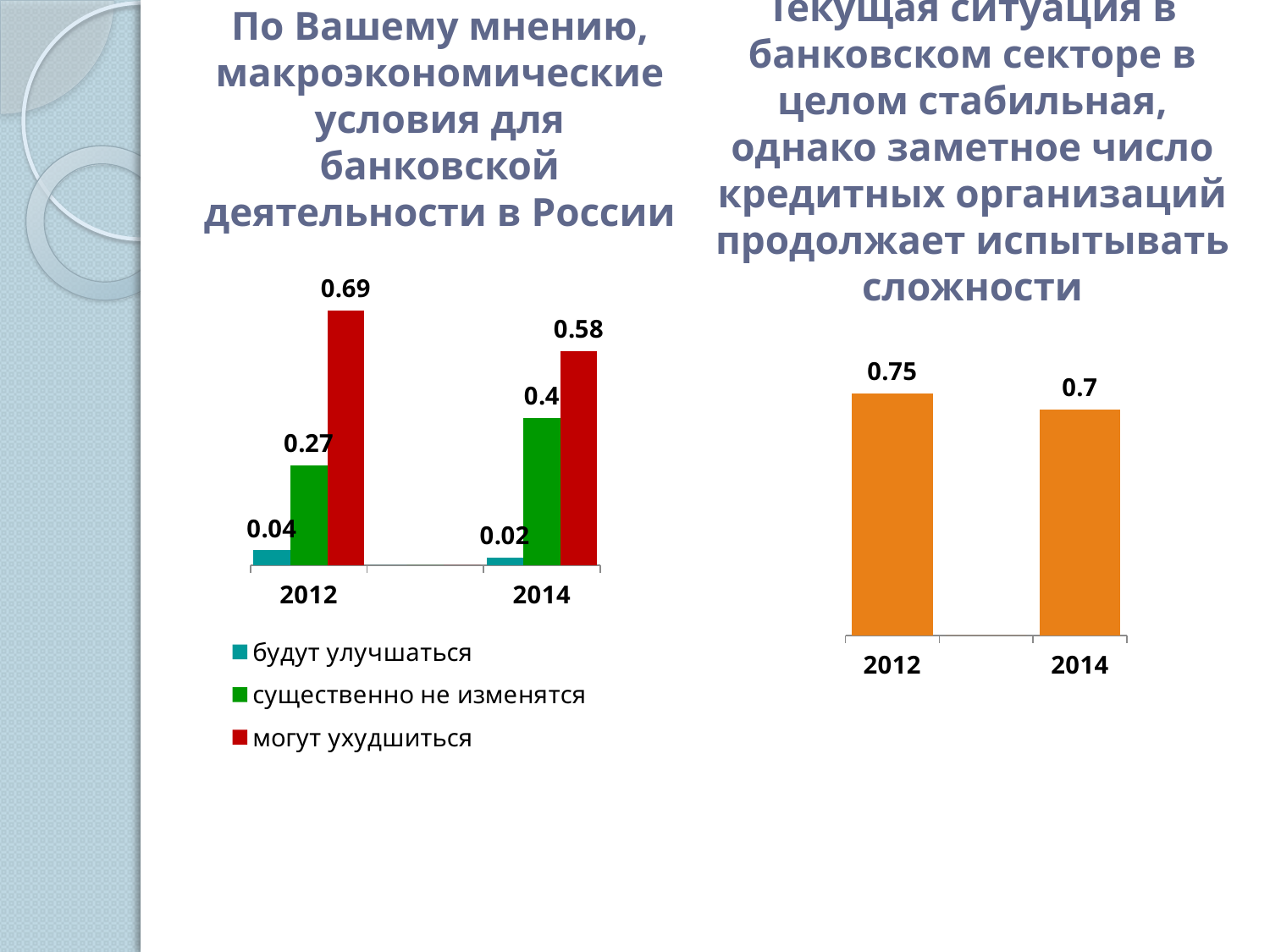
In the right chart (current situation in the banking sector), what is the value for 2014? 0.7 In the left chart (macroeconomic conditions for banking in Russia), which series has the highest value in 2012? могут ухудшиться In the right chart (current situation in the banking sector), what is the value for 2012? 0.75 What type of chart is the right chart (current situation in the banking sector)? Bar chart In the left chart (macroeconomic conditions for banking in Russia), what is the value for 'будут улучшаться' in 2012? 0.04 In the left chart (macroeconomic conditions for banking in Russia), what is the value for 'могут ухудшиться' in 2012? 0.69 In the left chart (macroeconomic conditions for banking in Russia), what is the value for 'существенно не изменятся' in 2014? 0.4 In the left chart (macroeconomic conditions for banking in Russia), which series has the lowest value in 2014? будут улучшаться In the left chart (macroeconomic conditions for banking in Russia), what is the difference between the 'могут ухудшиться' values for 2012 and 2014? 0.11 In the right chart (current situation in the banking sector), do the values rise or fall from 2012 to 2014? Fall In the left chart (macroeconomic conditions for banking in Russia), how many series does the legend list? 3 In the left chart (macroeconomic conditions for banking in Russia), which colour represents 'существенно не изменятся'? Green